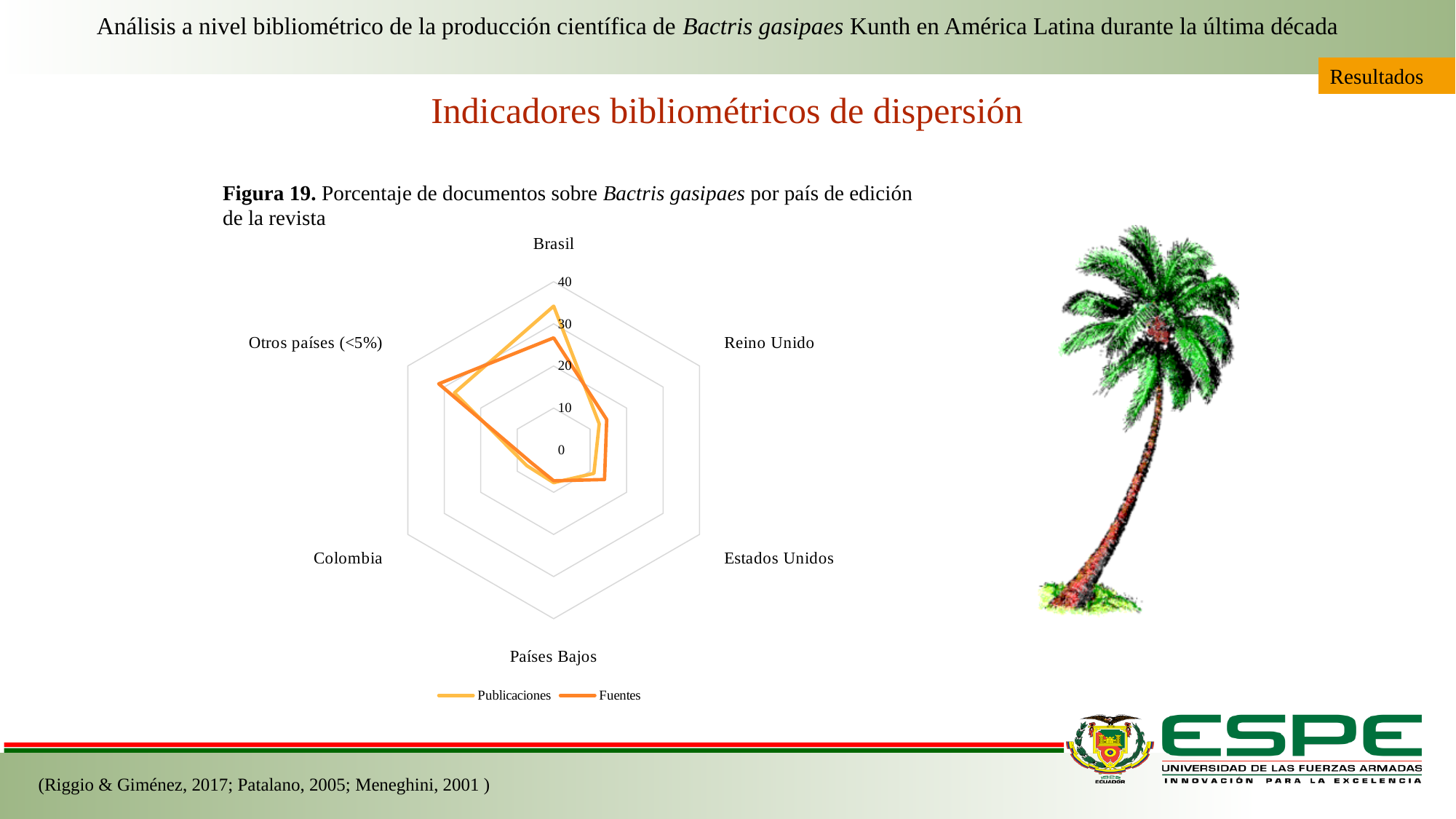
Is the Publicaciones value for Brasil greater or less than 30? greater For Brasil, which series has the larger value, Publicaciones or Fuentes? Publicaciones For the Fuentes series, which category has the highest value? Otros países (<5%) Is the Fuentes value for Reino Unido greater or less than 20? less Is the Fuentes value for Brasil greater or less than 30? less Which two series are listed in the chart legend? Publicaciones and Fuentes How many categories (countries/axes) does the radar chart have? 6 What is the highest value shown on the radial axis of the chart? 40 What kind of chart is shown in Figura 19? Radar chart How many series does the legend of the chart list? 2